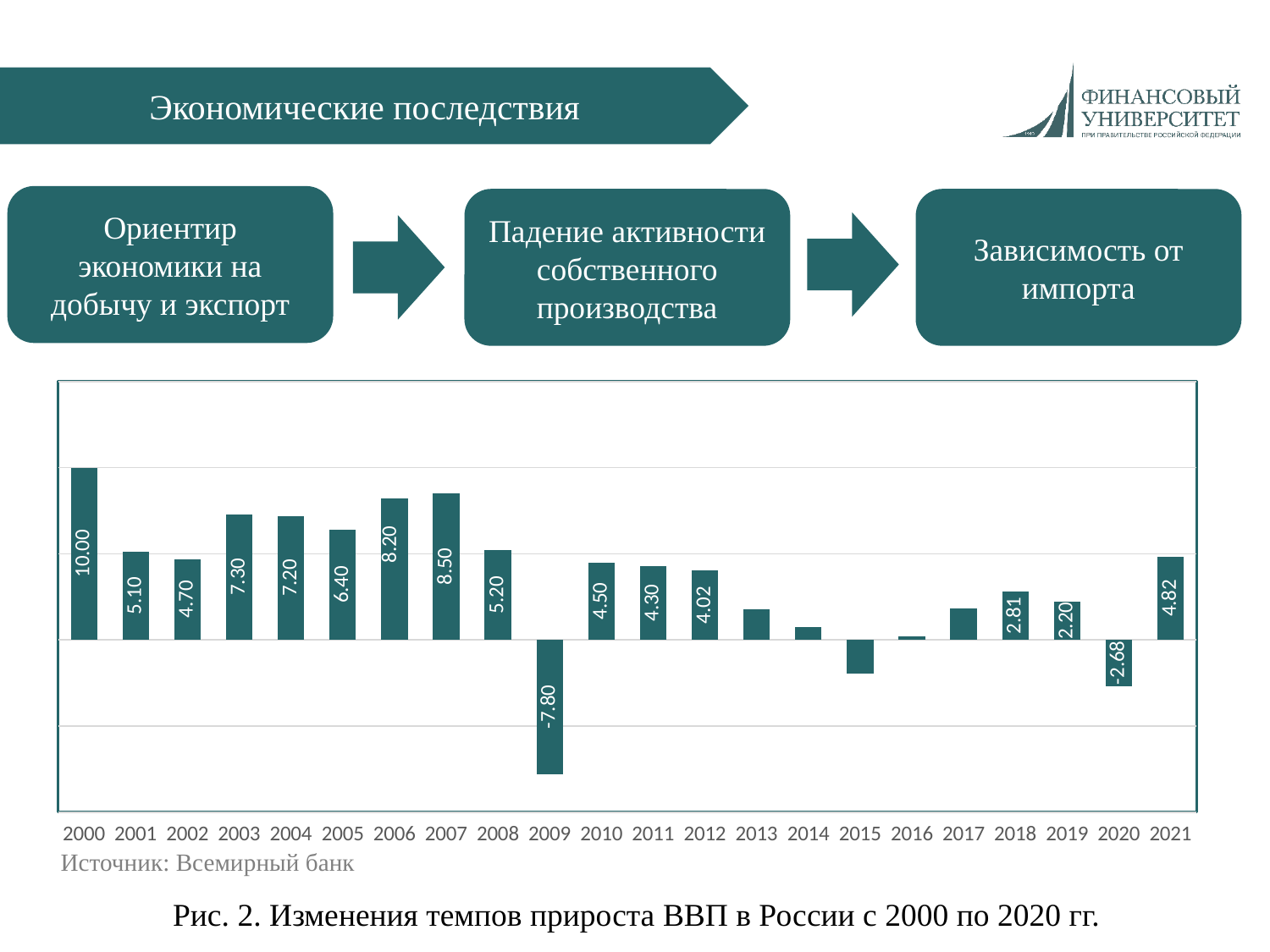
Which year has the lowest value? 2009 Do the values rise or fall from 2010 to 2012? Fall What is the value for 2009? -7.80 How many years are shown on the x axis? 22 What is the difference between the values for 2000 and 2001? 4.90 What is the value for 2021? 4.82 Which is larger, the value for 2003 or the value for 2004? 2003 What is the difference between the values for 2007 and 2006? 0.30 Which year has the highest value? 2000 What is the value for 2000? 10.00 What type of chart is shown on the slide? Bar chart What is the value for 2020? -2.68